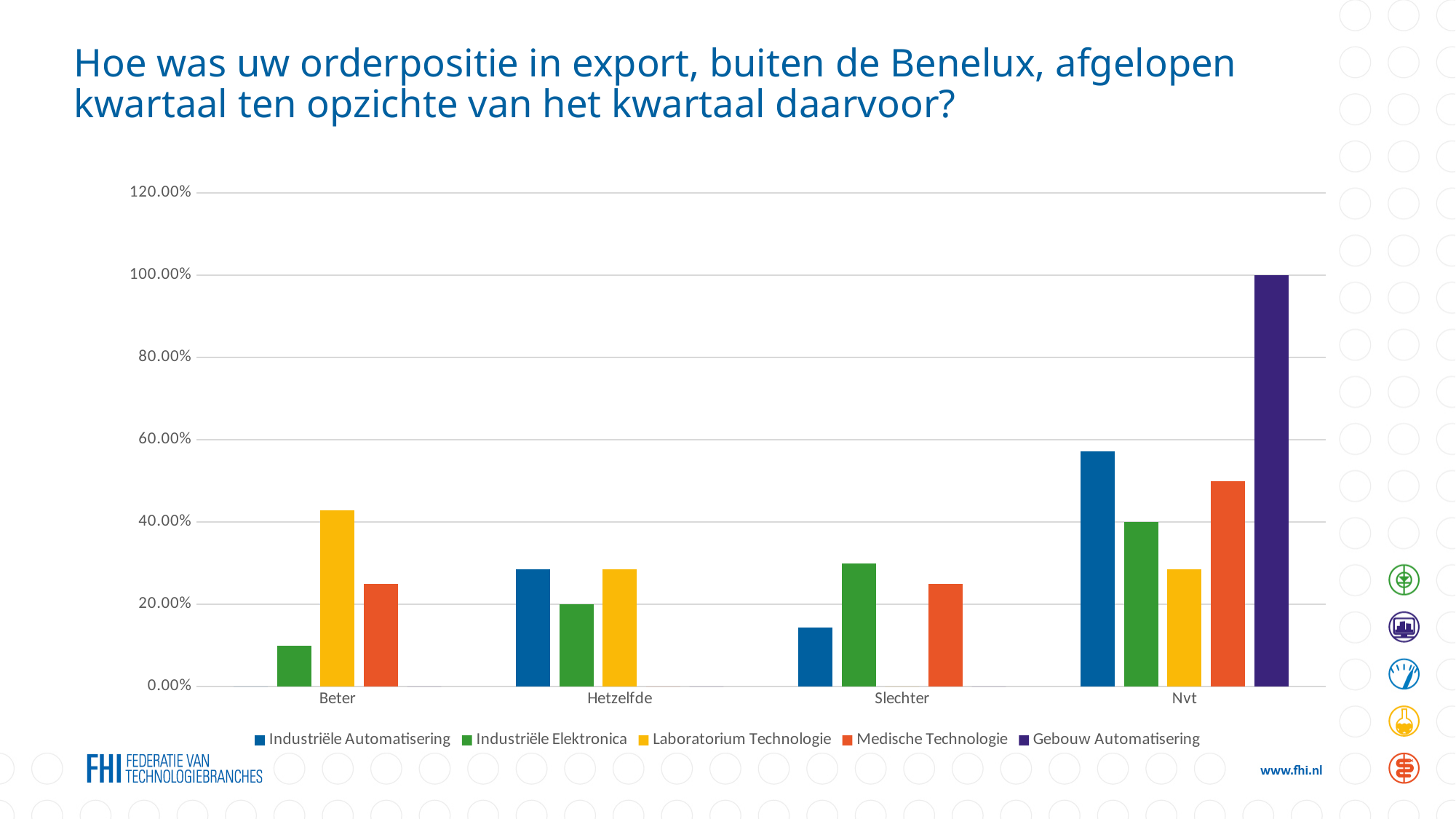
For Medische Technologie, which category has the highest value? Nvt How many series does the legend list? 5 What is the value for Gebouw Automatisering in the Nvt category? 100.00% What is the value for Industriële Elektronica in the Nvt category? 40.00% Is the value for Industriële Automatisering in the Nvt category greater or less than 40.00%? greater In the Slechter category, which is larger: Industriële Elektronica or Industriële Automatisering? Industriële Elektronica For Laboratorium Technologie, which category has the highest value? Beter What colour represents Gebouw Automatisering in the legend? purple What is the value for Industriële Elektronica in the Hetzelfde category? 20.00% How many categories are shown on the x axis? 4 Is the value for Industriële Elektronica in the Beter category greater or less than 20.00%? less What kind of chart is shown on the slide? bar chart